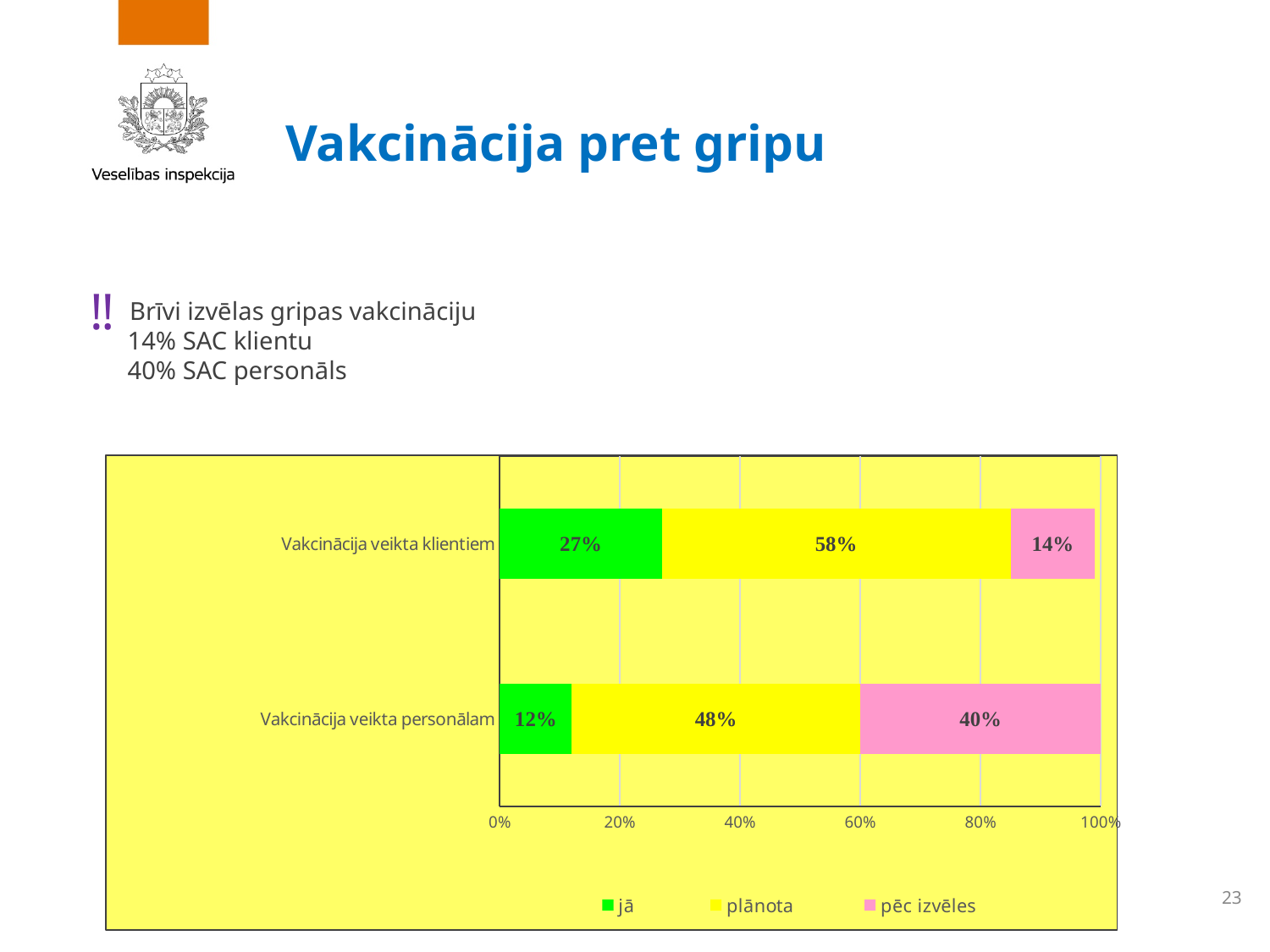
What is the value of "pēc izvēles" for "Vakcinācija veikta personālam"? 40% Which category has the lower "plānota" value? Vakcinācija veikta personālam What is the value of "jā" for "Vakcinācija veikta klientiem"? 27% How many categories are shown on the chart? 2 Which category has the higher "jā" value? Vakcinācija veikta klientiem What is the difference between the "plānota" values for "Vakcinācija veikta klientiem" and "Vakcinācija veikta personālam"? 10% What is the value of "plānota" for "Vakcinācija veikta personālam"? 48% How many series does the legend list? 3 What is the difference between the "pēc izvēles" values for "Vakcinācija veikta personālam" and "Vakcinācija veikta klientiem"? 26% What colour represents the "pēc izvēles" series in the legend? Pink What kind of chart is shown on the slide? Stacked bar chart What is the value of "pēc izvēles" for "Vakcinācija veikta klientiem"? 14%